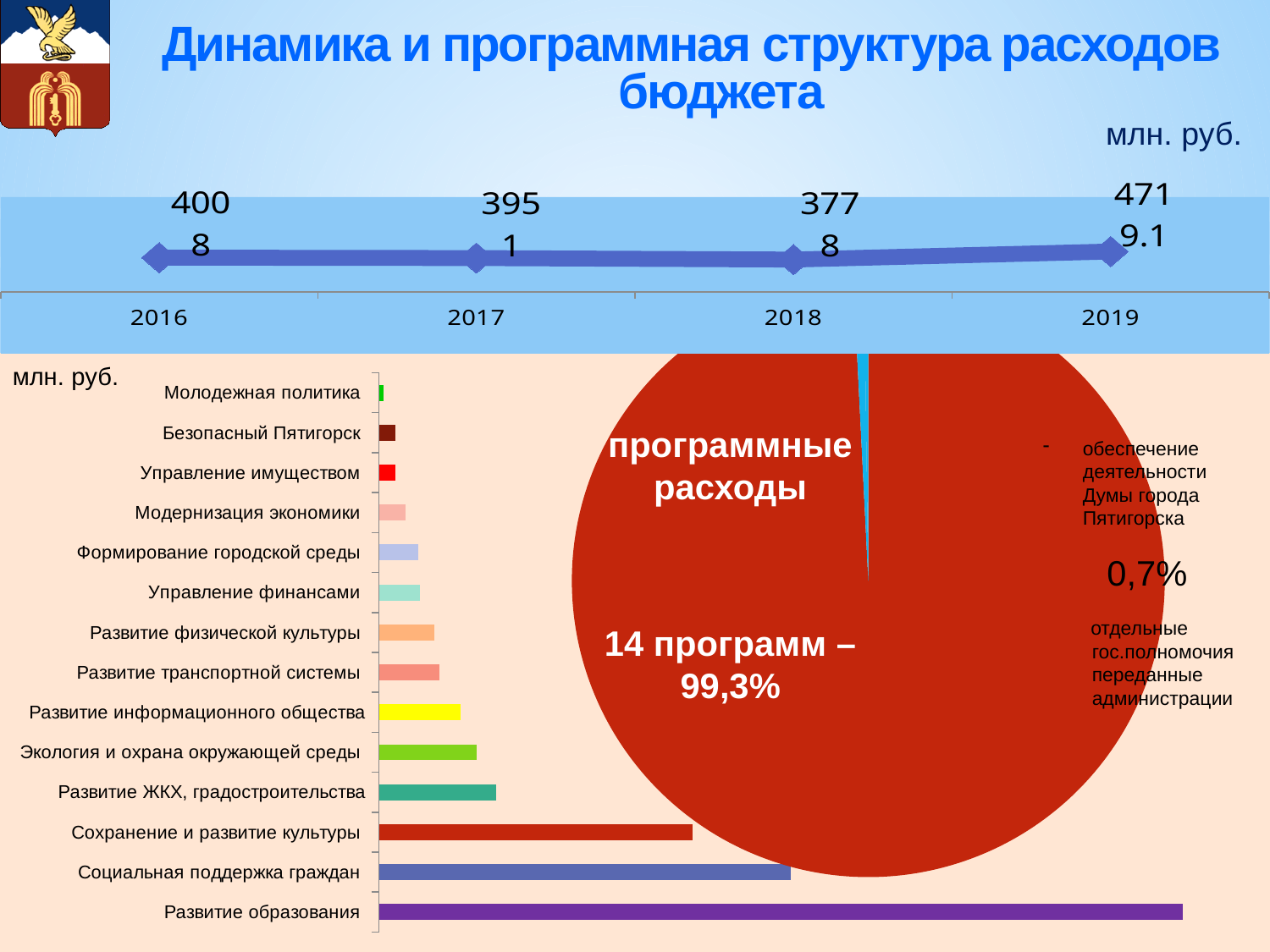
What kind of chart is the top chart showing values for 2016 to 2019? line chart On the bottom-right pie chart, what share is shown for the small slice (обеспечение деятельности Думы города Пятигорска and отдельные гос.полномочия)? 0,7% How many years are plotted on the top line chart? 4 On the bottom-left bar chart, which is larger: Социальная поддержка граждан or Сохранение и развитие культуры? Социальная поддержка граждан What kind of chart is the bottom-left chart listing programmes such as Развитие образования? bar chart On the bottom-right pie chart, what share do the 14 programmes (программные расходы) account for? 99,3% On the top line chart, which year has the highest value? 2019 What kind of chart is the bottom-right chart showing программные расходы? pie chart On the bottom-left bar chart, which programme has the shortest bar? Молодежная политика On the bottom-left bar chart, which programme has the longest bar? Развитие образования How many programme categories are shown on the bottom-left bar chart? 14 On the bottom-left bar chart, which is larger: Развитие информационного общества or Управление финансами? Развитие информационного общества